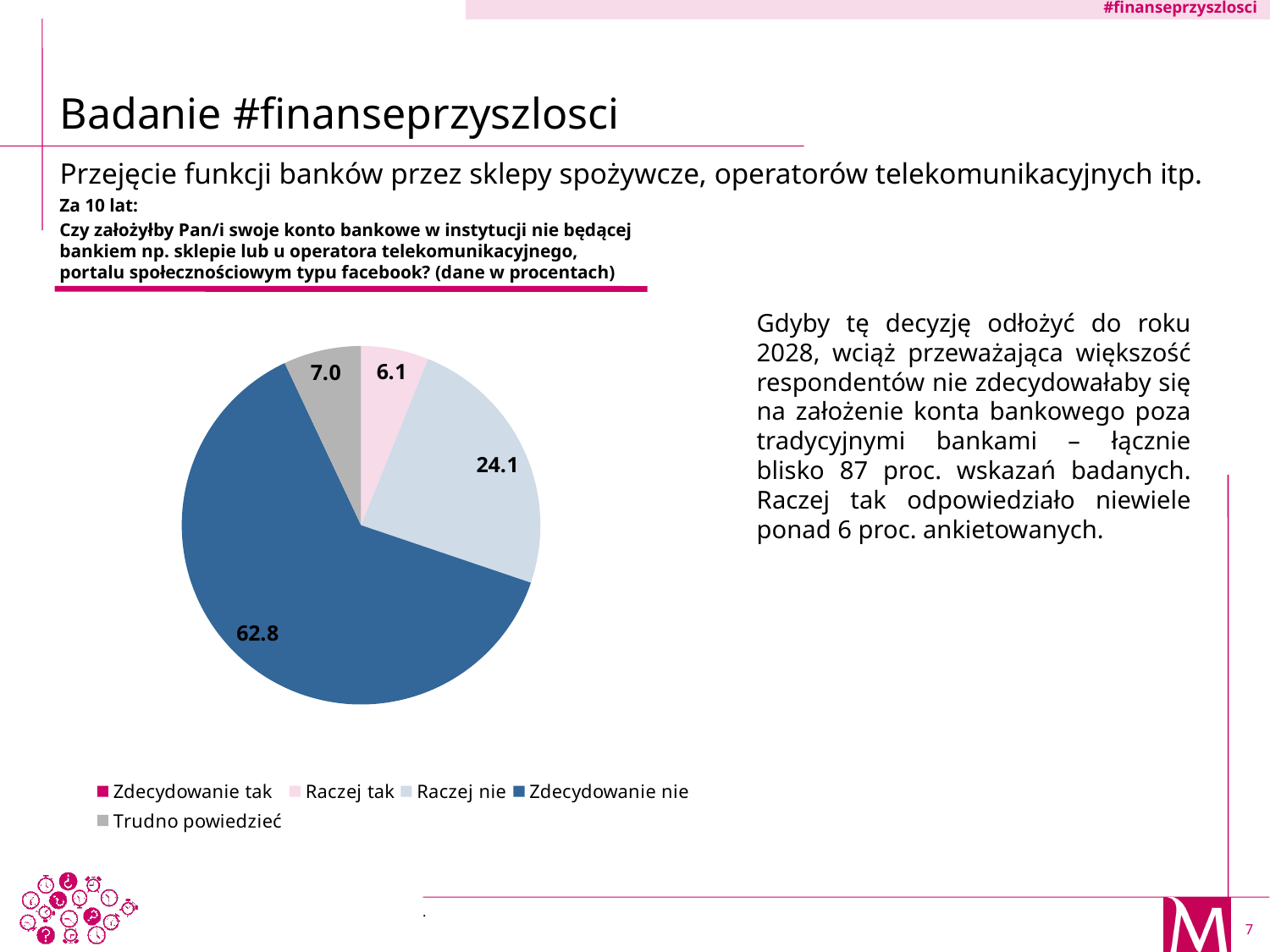
Which of the labelled slices in the pie chart is the smallest? Raczej tak What value is shown for the 'Raczej nie' slice of the pie chart? 24.1 What is the difference between the 'Zdecydowanie nie' and 'Raczej nie' values in the pie chart? 38.7 What type of chart is shown on the slide? Pie chart What value is shown for the 'Raczej tak' slice of the pie chart? 6.1 Which response category has the largest slice in the pie chart? Zdecydowanie nie What value is shown for the 'Zdecydowanie nie' slice of the pie chart? 62.8 Which is larger in the pie chart: 'Raczej nie' or 'Trudno powiedzieć'? Raczej nie What is the combined value of the 'Raczej nie' and 'Zdecydowanie nie' slices? 86.9 How many response categories does the legend of the chart list? 5 What is the difference between the 'Trudno powiedzieć' and 'Raczej tak' values in the pie chart? 0.9 What value is shown for the 'Trudno powiedzieć' slice of the pie chart? 7.0